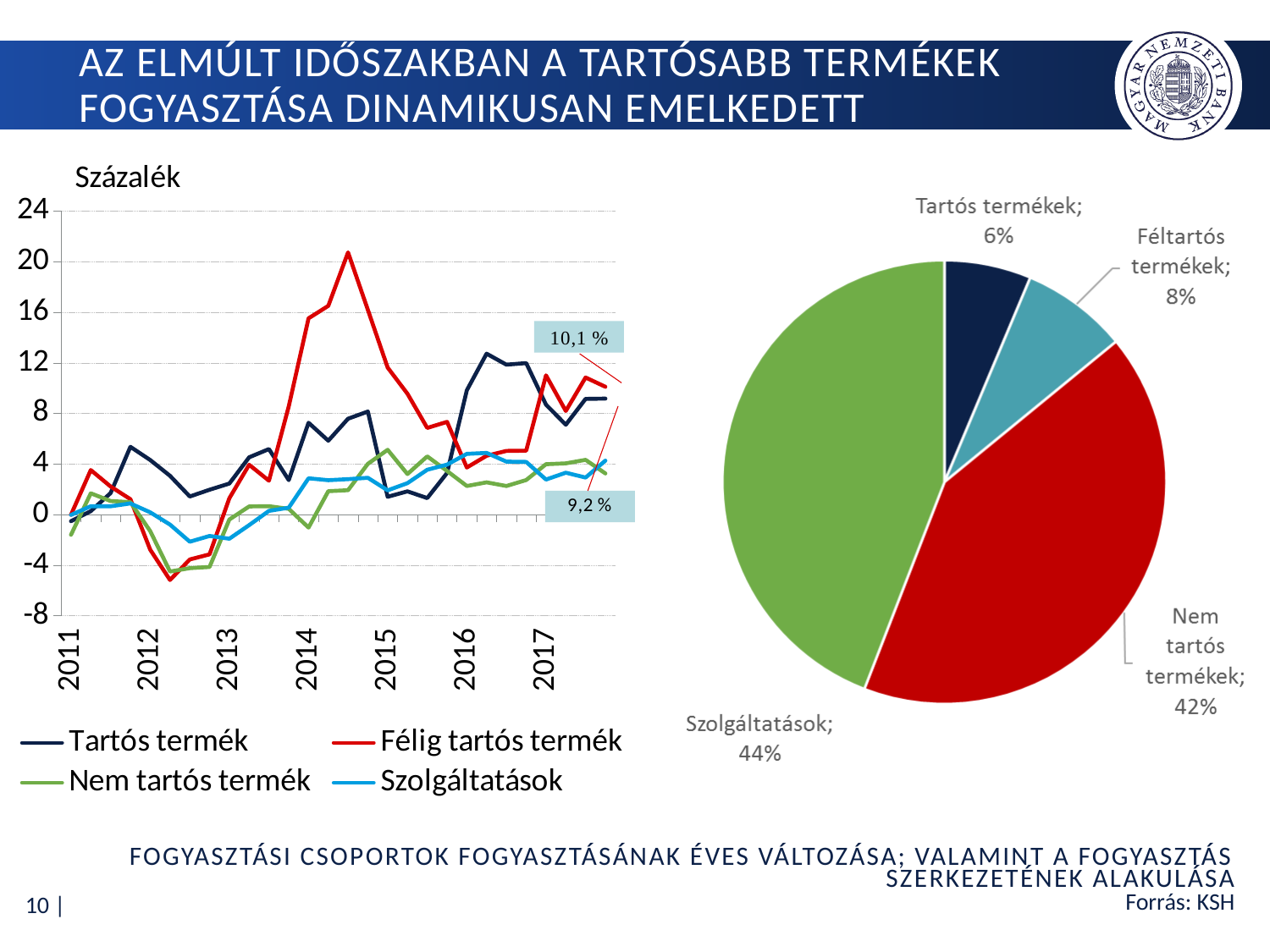
In the pie chart on the right, what share do Nem tartós termékek have? 42% In the pie chart on the right, what share do Féltartós termékek have? 8% In the pie chart on the right, which category has the largest slice? Szolgáltatások In the pie chart on the right, what share do Szolgáltatások have? 44% In the pie chart on the right, which is larger: Féltartós termékek or Tartós termékek? Féltartós termékek What kind of chart is the chart on the left of the slide? Line chart In the pie chart on the right, what is the difference in percentage points between Szolgáltatások and Nem tartós termékek? 2 percentage points In the pie chart on the right, which category has the smallest slice? Tartós termékek In the line chart on the left, is the peak value of Félig tartós termék in 2014 greater or less than 16? greater In the line chart on the left, which series reaches the highest value over the whole period? Félig tartós termék How many slices does the pie chart on the right have? 4 How many series does the legend of the line chart on the left list? 4